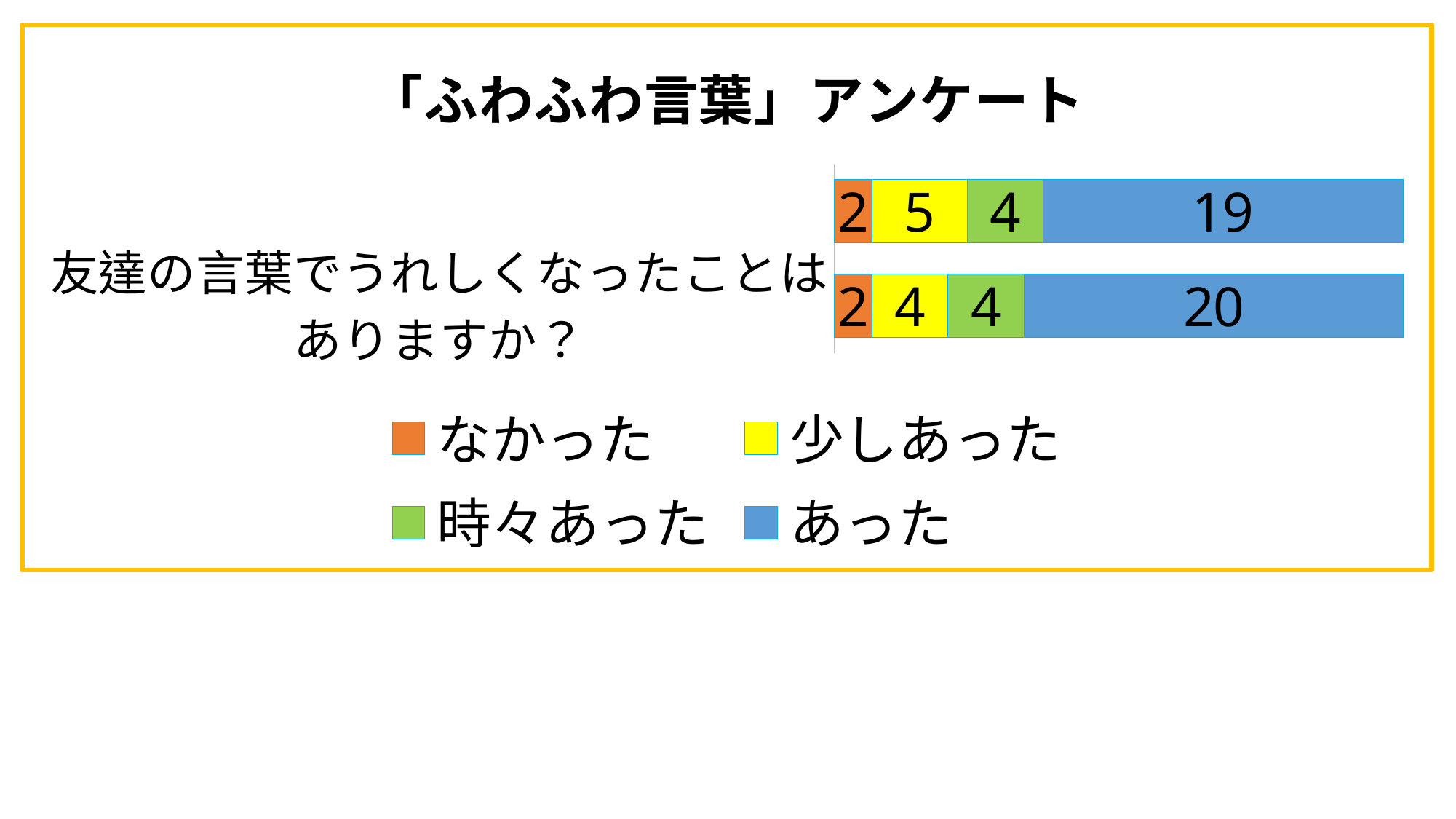
Which colour represents 時々あった in the legend? green What is the difference between the あった values of the bottom bar and the top bar? 1 What is the value of あった in the top bar? 19 What is the value of あった in the bottom bar? 20 What kind of chart is shown on the slide? stacked bar chart How many series does the legend list? 4 Which series has the largest value in the bottom bar? あった How many bars are plotted in the chart? 2 What is the total of the top stacked bar? 30 What is the value of 少しあった in the top bar? 5 What is the total of the bottom stacked bar? 30 What is the value of なかった in the bottom bar? 2